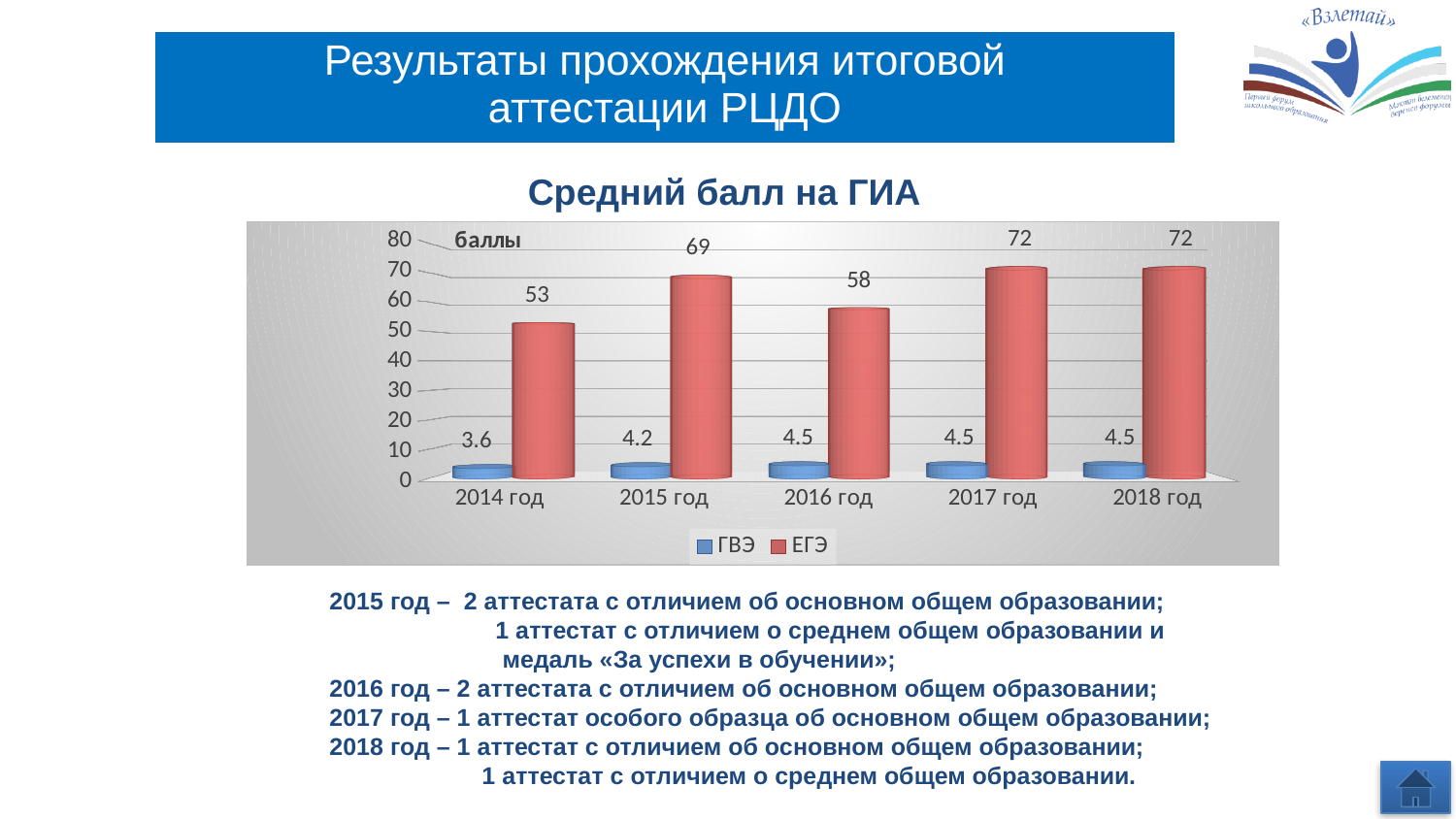
How many series does the legend list? 2 What is the difference between the ЕГЭ values for 2017 год and 2014 год? 19 Which year has the lowest ГВЭ value? 2014 год What is the ЕГЭ value for 2015 год? 69 Which year has the lowest ЕГЭ value? 2014 год Which is larger, the ЕГЭ value for 2015 год or for 2016 год? 2015 год What type of chart is shown? bar chart How many years are shown on the x axis? 5 What is the difference between the ГВЭ values for 2015 год and 2014 год? 0.6 What is the ЕГЭ value for 2016 год? 58 Is the ЕГЭ value for 2014 год greater or less than 60? less What is the ГВЭ value for 2014 год? 3.6